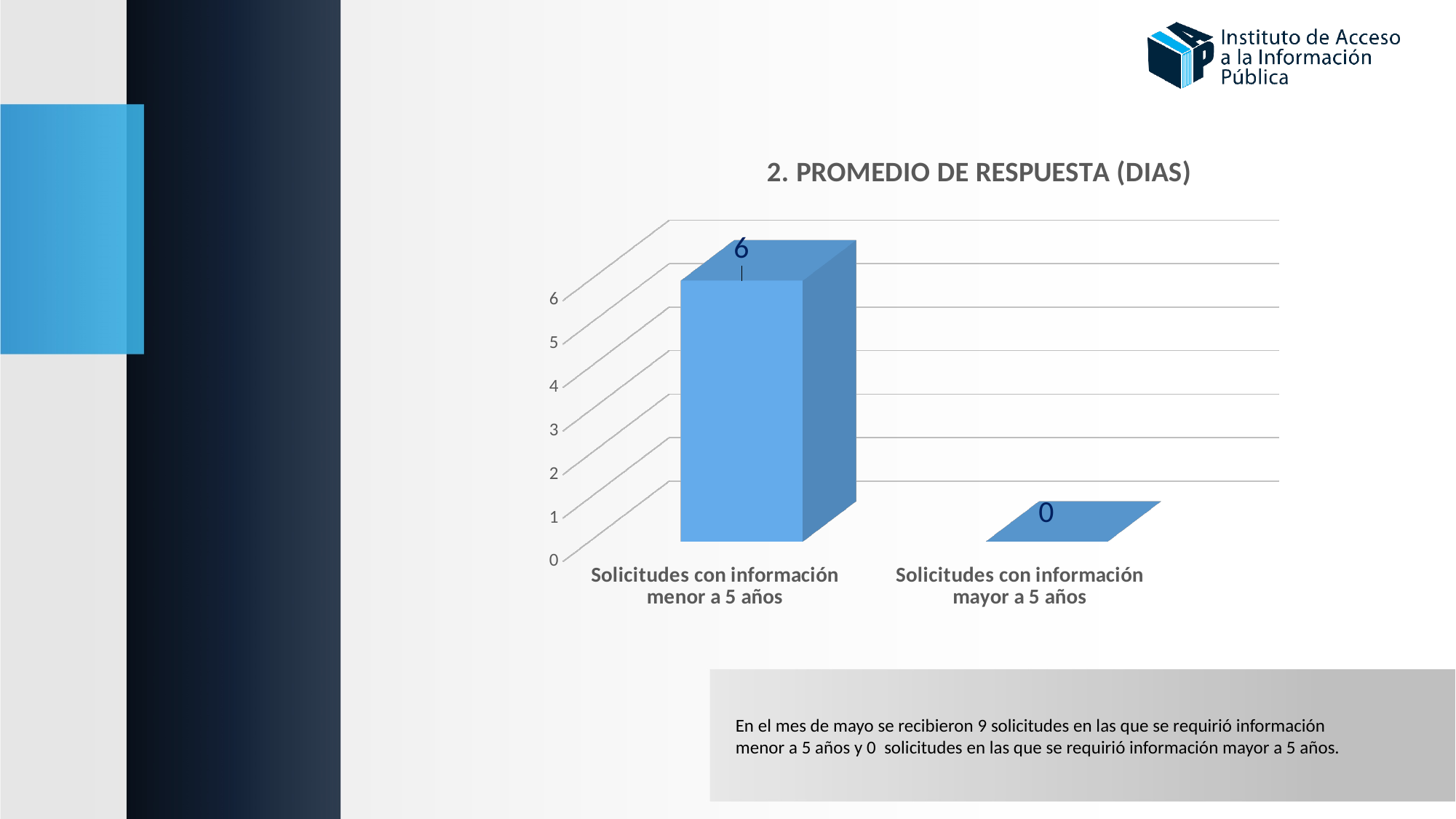
Which category has the highest value? Solicitudes con información menor a 5 años Which category has the lowest value? Solicitudes con información mayor a 5 años What is the value for "Solicitudes con información mayor a 5 años"? 0 What is the difference between the values for "Solicitudes con información menor a 5 años" and "Solicitudes con información mayor a 5 años"? 6 What is the highest tick value shown on the vertical axis? 6 What is the title of the chart? 2. PROMEDIO DE RESPUESTA (DIAS) Is the value for "Solicitudes con información menor a 5 años" greater or less than 3? greater What kind of chart is shown on the slide? bar chart How many categories are shown on the x axis? 2 Which is larger: the value for "Solicitudes con información menor a 5 años" or for "Solicitudes con información mayor a 5 años"? Solicitudes con información menor a 5 años What is the value for "Solicitudes con información menor a 5 años"? 6 Do the values rise or fall from left to right along the x axis? fall